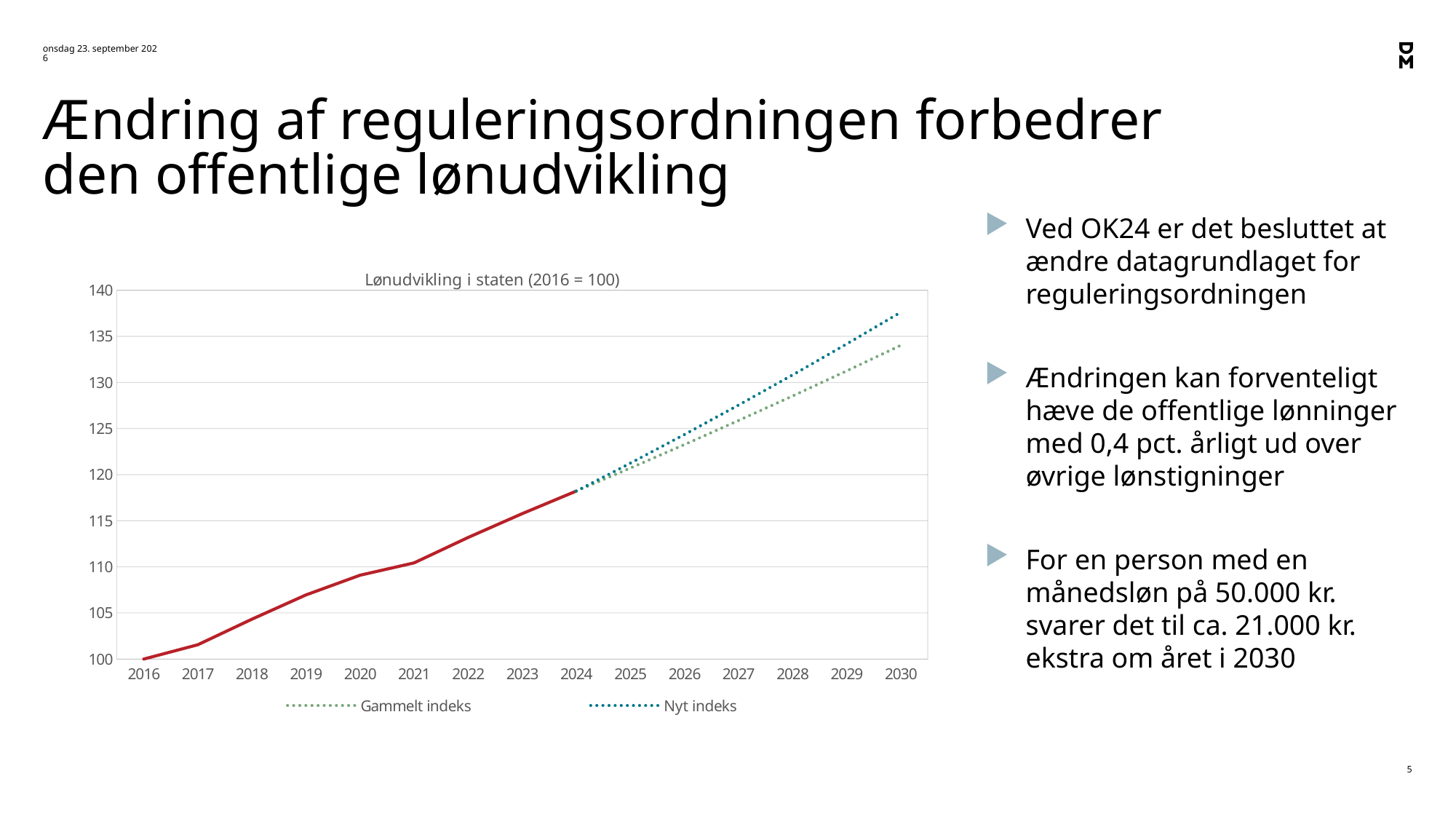
In 2030, which series is higher, Gammelt indeks or Nyt indeks? Nyt indeks Is the index value for 2020 greater or less than 110? less Is the index value for 2024 greater or less than 120? less What kind of chart is shown on the slide? line chart What is the title of the chart? Lønudvikling i staten (2016 = 100) How many years are shown on the x axis of the chart? 15 Is the value for Nyt indeks in 2030 greater or less than 135? greater What is the index value for 2016 in the chart? 100 How many series does the chart legend list? 2 Do the index values rise or fall from 2016 to 2030? rise Which year has the lowest index value in the chart? 2016